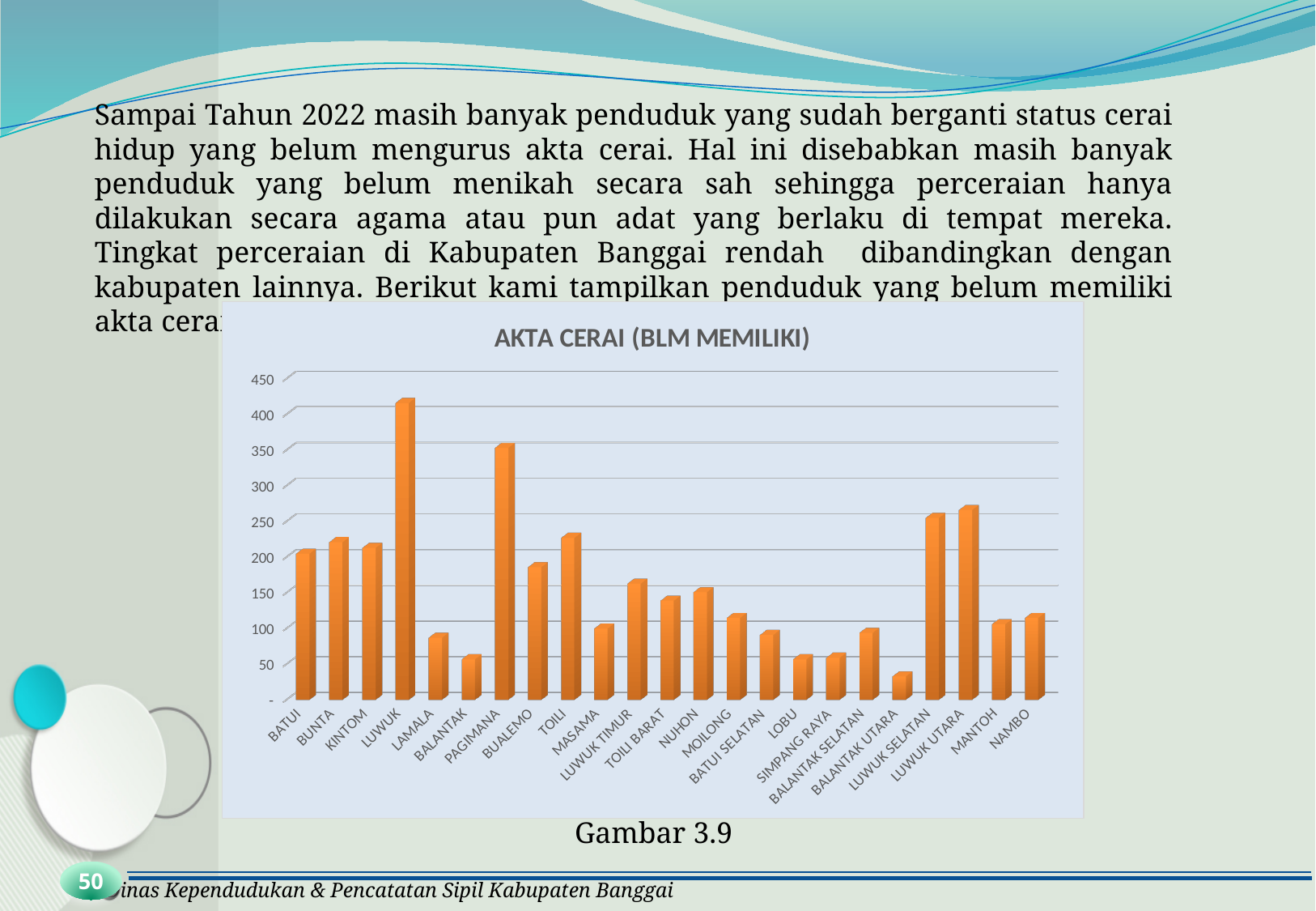
Is the value for LUWUK greater or less than 400? greater Which category has the lowest value in the chart? BALANTAK UTARA Is the value for PAGIMANA greater or less than 300? greater Is the value for LUWUK UTARA greater or less than 200? greater How many categories (districts) are shown on the x axis of the chart? 23 What kind of chart is shown on the slide? bar chart Which category has the highest value in the chart? LUWUK Which has a larger value, BUNTA or LAMALA? BUNTA What is the title of the chart? AKTA CERAI (BLM MEMILIKI) Which has a larger value, LUWUK or PAGIMANA? LUWUK